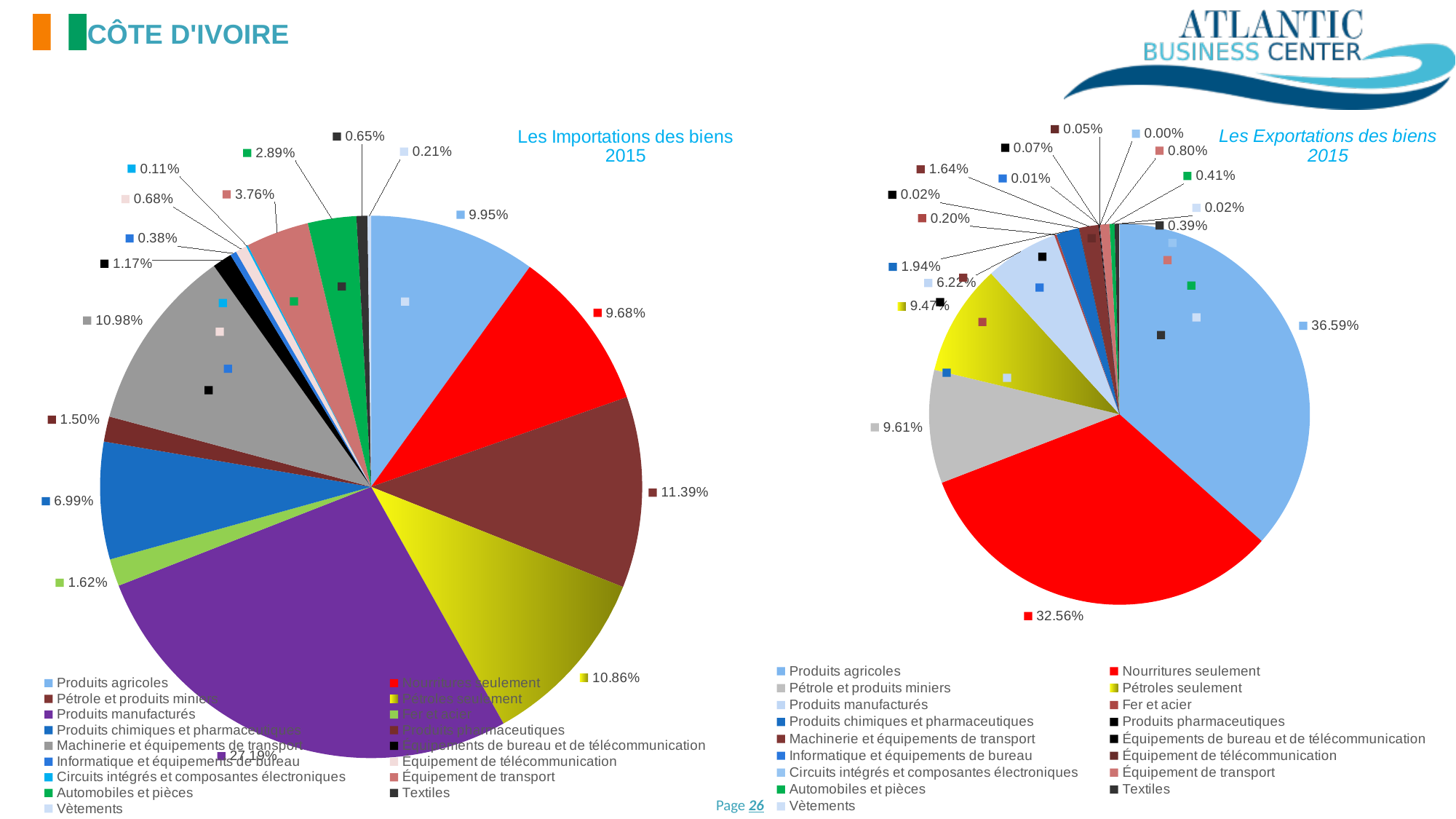
In the 'Les Exportations des biens 2015' chart, which category has the largest slice? Produits agricoles In the 'Les Exportations des biens 2015' chart, what is the share for Pétrole et produits miniers? 9.61% How many categories does the legend of the 'Les Exportations des biens 2015' chart list? 17 In the 'Les Importations des biens 2015' chart, what is the largest share shown? 27.19% What is the title of the chart on the left of the slide? Les Importations des biens 2015 In the 'Les Importations des biens 2015' chart, which is larger: Pétrole et produits miniers or Pétroles seulement? Pétrole et produits miniers In the 'Les Exportations des biens 2015' chart, what is the difference between the Produits agricoles share and the Nourritures seulement share? 4.03% In the 'Les Importations des biens 2015' chart, which category has the largest slice? Produits manufacturés In the 'Les Importations des biens 2015' chart, what is the share for Machinerie et équipements de transport? 10.98% In the 'Les Exportations des biens 2015' chart, what is the share for Produits agricoles? 36.59% What type of chart is used for 'Les Importations des biens 2015'? pie chart In the 'Les Exportations des biens 2015' chart, what is the share for Nourritures seulement? 32.56%